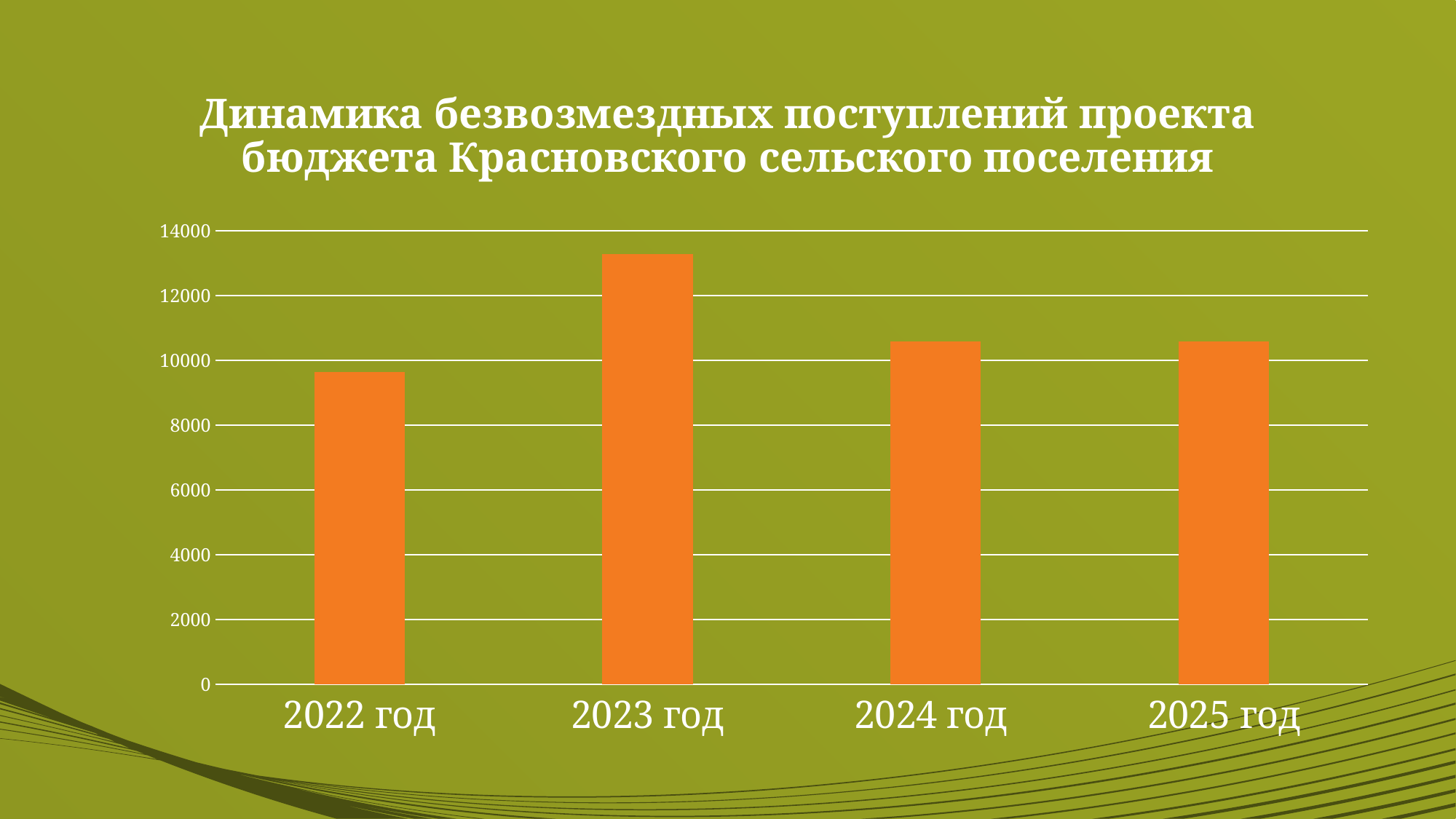
What kind of chart is shown on the slide? bar chart Is the value for 2024 год greater or less than 10000? greater Is the value for 2023 год greater or less than 12000? greater Which year has the lowest value in the chart? 2022 год How many years (categories) are shown on the x axis of the chart? 4 Is the value for 2023 год greater or less than 14000? less Which year has the highest value in the chart? 2023 год Which is larger, the value for 2022 год or the value for 2023 год? 2023 год What is the title of the chart on the slide? Динамика безвозмездных поступлений проекта бюджета Красновского сельского поселения Which is larger, the value for 2022 год or the value for 2024 год? 2024 год